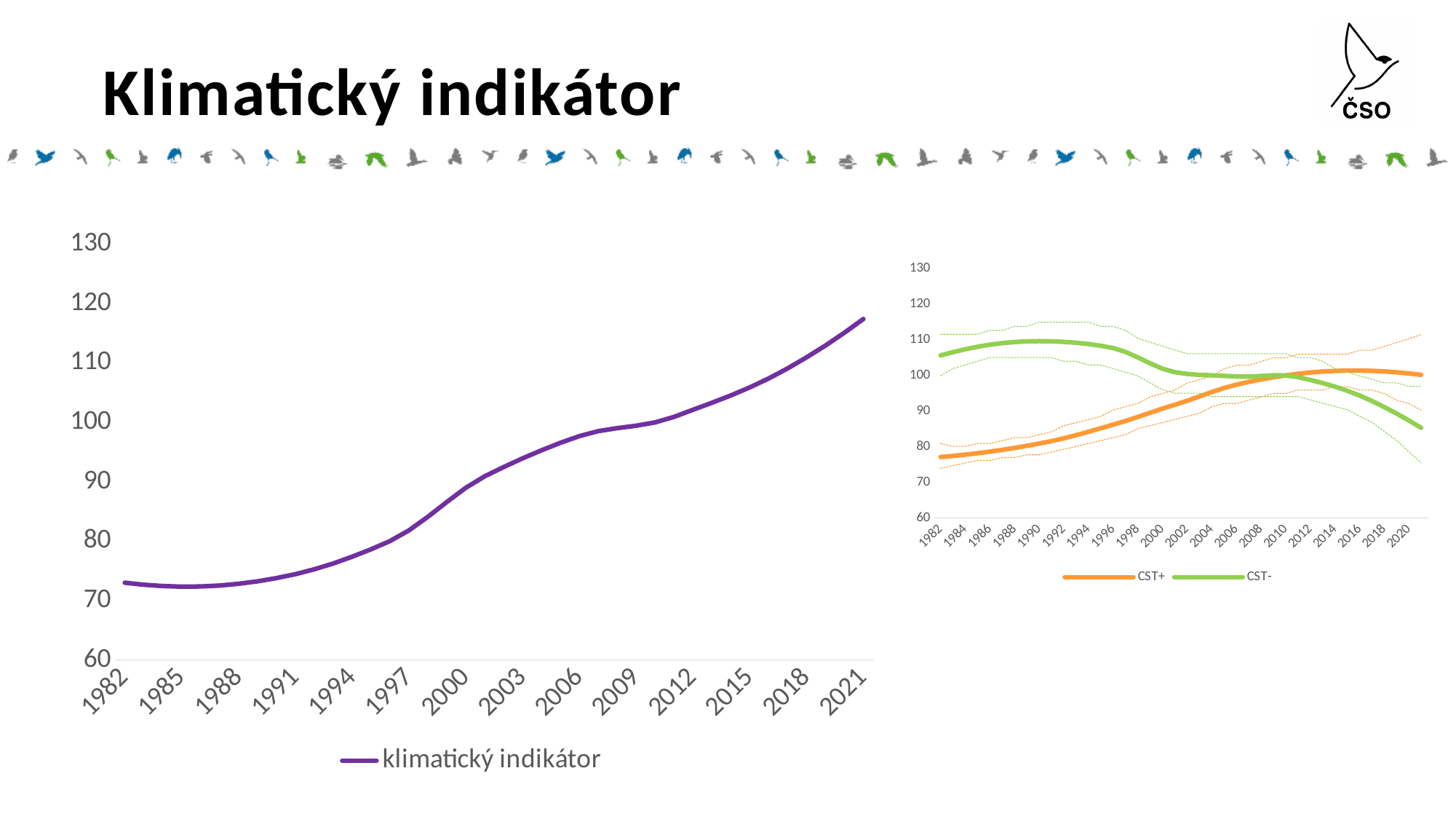
On the left chart, is the value of the klimatický indikátor in 2021 greater or less than 110? greater On the right chart, how many series does the legend list? 2 On the left chart, is the value of the klimatický indikátor in 1982 greater or less than 80? less On the left chart, is the value of the klimatický indikátor in 2015 greater or less than 100? greater On the left chart, does the klimatický indikátor rise or fall overall from 1982 to 2021? rise On the left chart, how many series does the legend list? 1 On the right chart, which series has the higher value in 1982, CST+ or CST-? CST- On the right chart, which series is drawn in orange? CST+ On the left chart, what kind of chart is used to show the klimatický indikátor? line chart On the right chart, does the CST+ series rise or fall overall from 1982 to 2020? rise